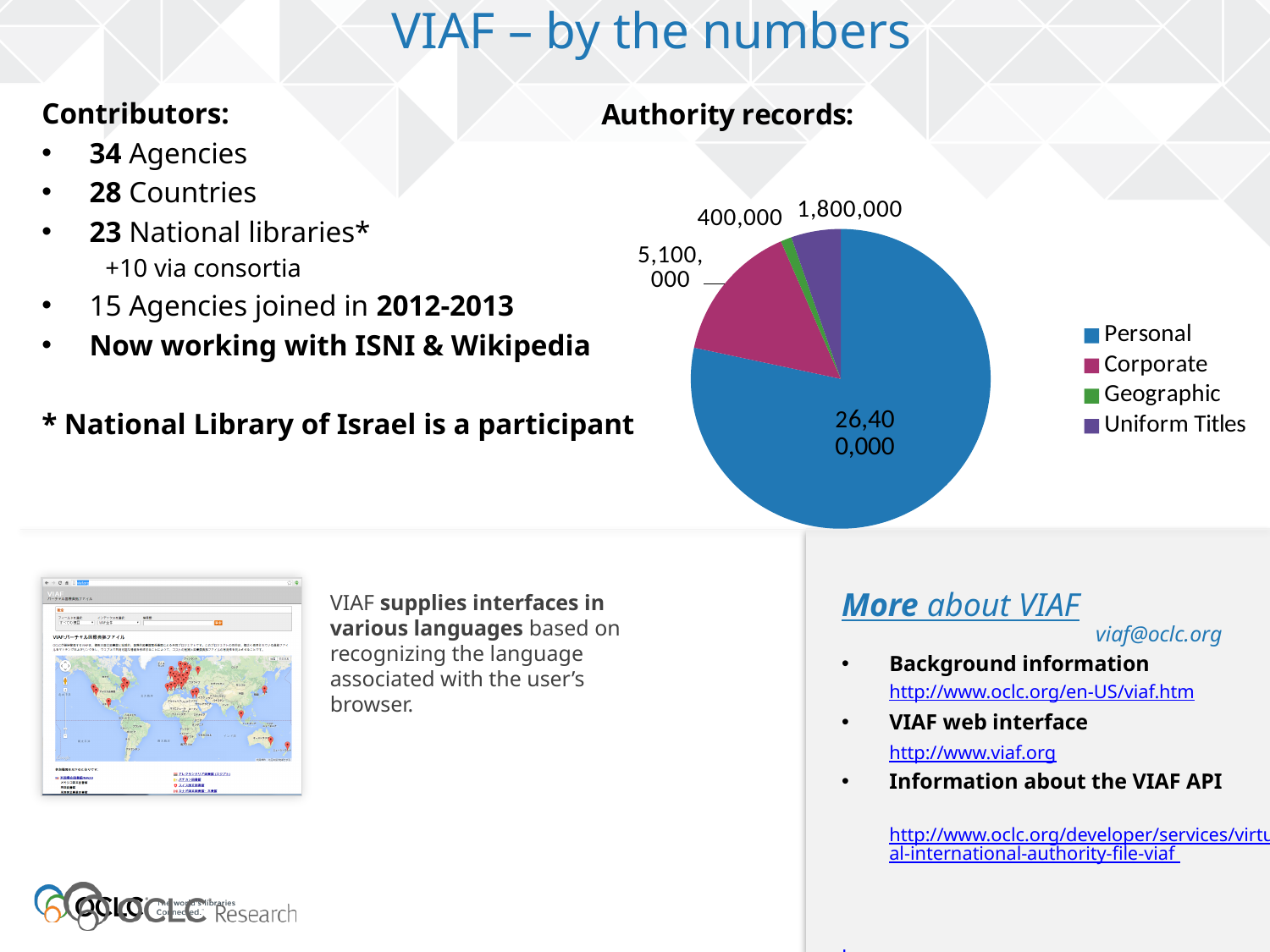
What is the value shown for Corporate authority records in the pie chart? 5,100,000 Which legend entry in the pie chart is shown in green? Geographic Which category has the largest slice in the Authority records pie chart? Personal What type of chart is shown under "Authority records:"? pie chart What is the difference between the Personal and Corporate values in the pie chart? 21,300,000 In the pie chart, which is larger: Corporate or Uniform Titles? Corporate What is the value shown for Uniform Titles in the pie chart? 1,800,000 What is the total of all four values shown in the Authority records pie chart? 33,700,000 Which category has the smallest slice in the Authority records pie chart? Geographic How many categories does the legend of the Authority records pie chart list? 4 What is the value shown for Personal authority records in the pie chart? 26,400,000 What is the value shown for Geographic authority records in the pie chart? 400,000